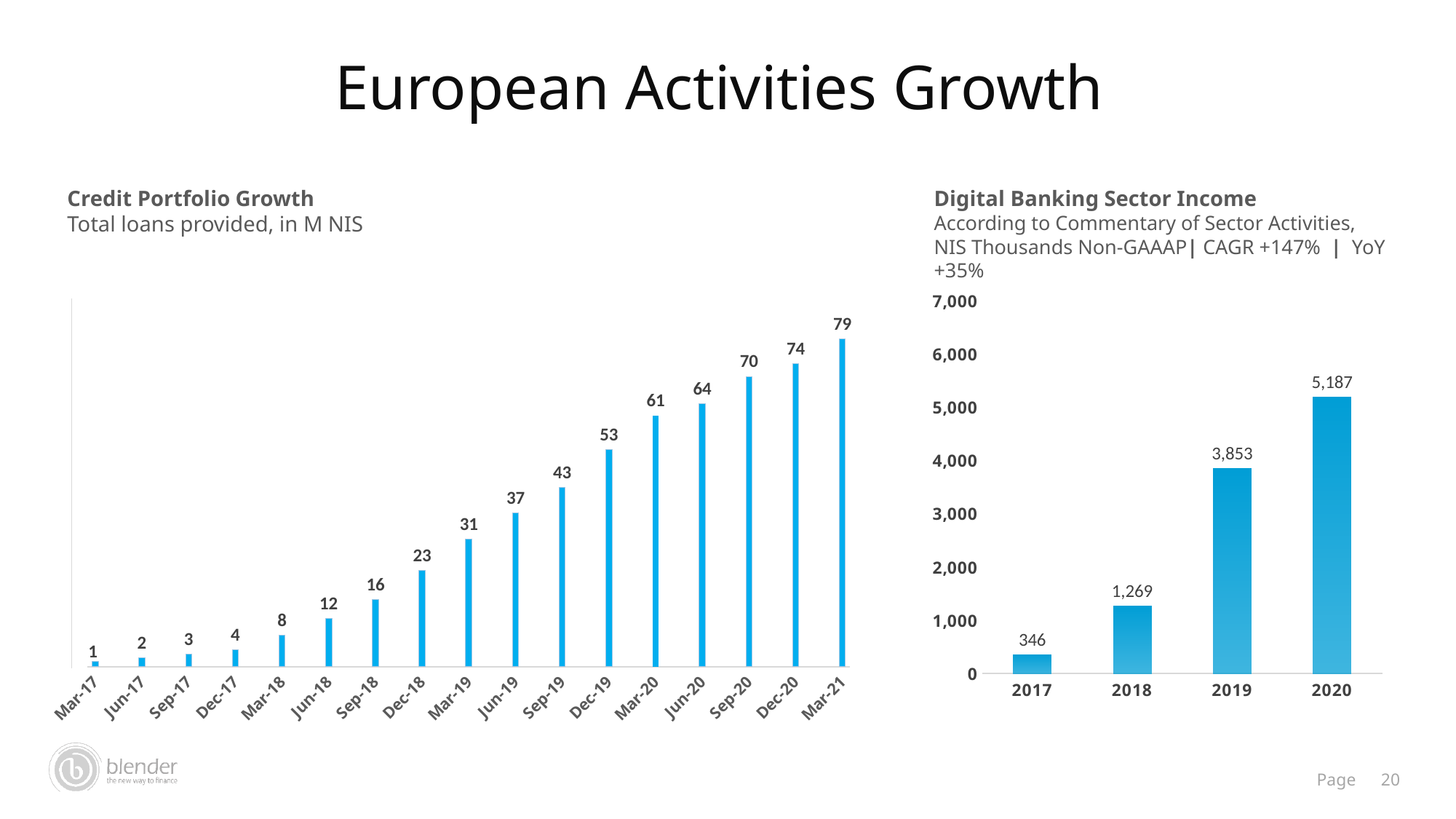
In the Digital Banking Sector Income chart, what is the value for 2017? 346 In the Credit Portfolio Growth chart, what is the value for Dec-19? 53 In the Credit Portfolio Growth chart, what is the difference between the values for Mar-21 and Mar-20? 18 In the Credit Portfolio Growth chart, which period has the highest value? Mar-21 In the Digital Banking Sector Income chart, which year has the highest value? 2020 In the Credit Portfolio Growth chart, how many periods are shown on the x axis? 17 In the Credit Portfolio Growth chart, do the values rise or fall from Mar-17 to Mar-21? rise In the Digital Banking Sector Income chart, what is the value for 2019? 3,853 In the Credit Portfolio Growth chart, which period has the lowest value? Mar-17 In the Credit Portfolio Growth chart, what is the value for Mar-18? 8 In the Digital Banking Sector Income chart, what is the difference between the values for 2020 and 2018? 3,918 What kind of chart is the Digital Banking Sector Income chart? bar chart